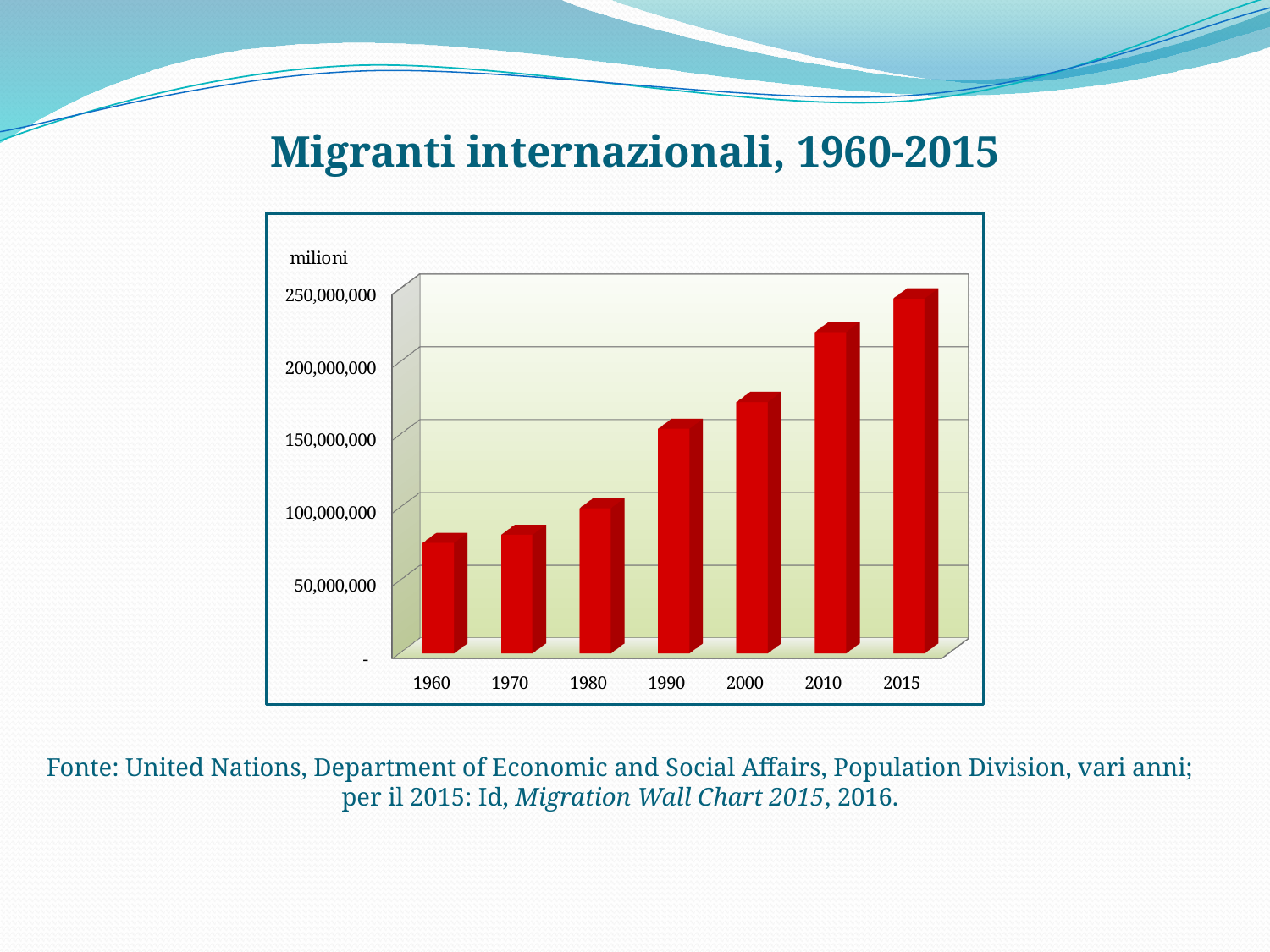
What is the title of the chart on the slide? Migranti internazionali, 1960-2015 What kind of chart is shown on the slide? bar chart Is the value for 1960 greater or less than 100,000,000? less Is the value for 1960 greater or less than 50,000,000? greater Which year has the highest number of international migrants in the chart? 2015 Do the values in the chart rise or fall from 1960 to 2015? rise Which year has the lowest number of international migrants in the chart? 1960 Which year has the larger value, 2000 or 2010? 2010 Is the value for 2010 greater or less than 200,000,000? greater How many years (categories) are shown on the x axis of the chart? 7 Which year has the larger value, 1970 or 1990? 1990